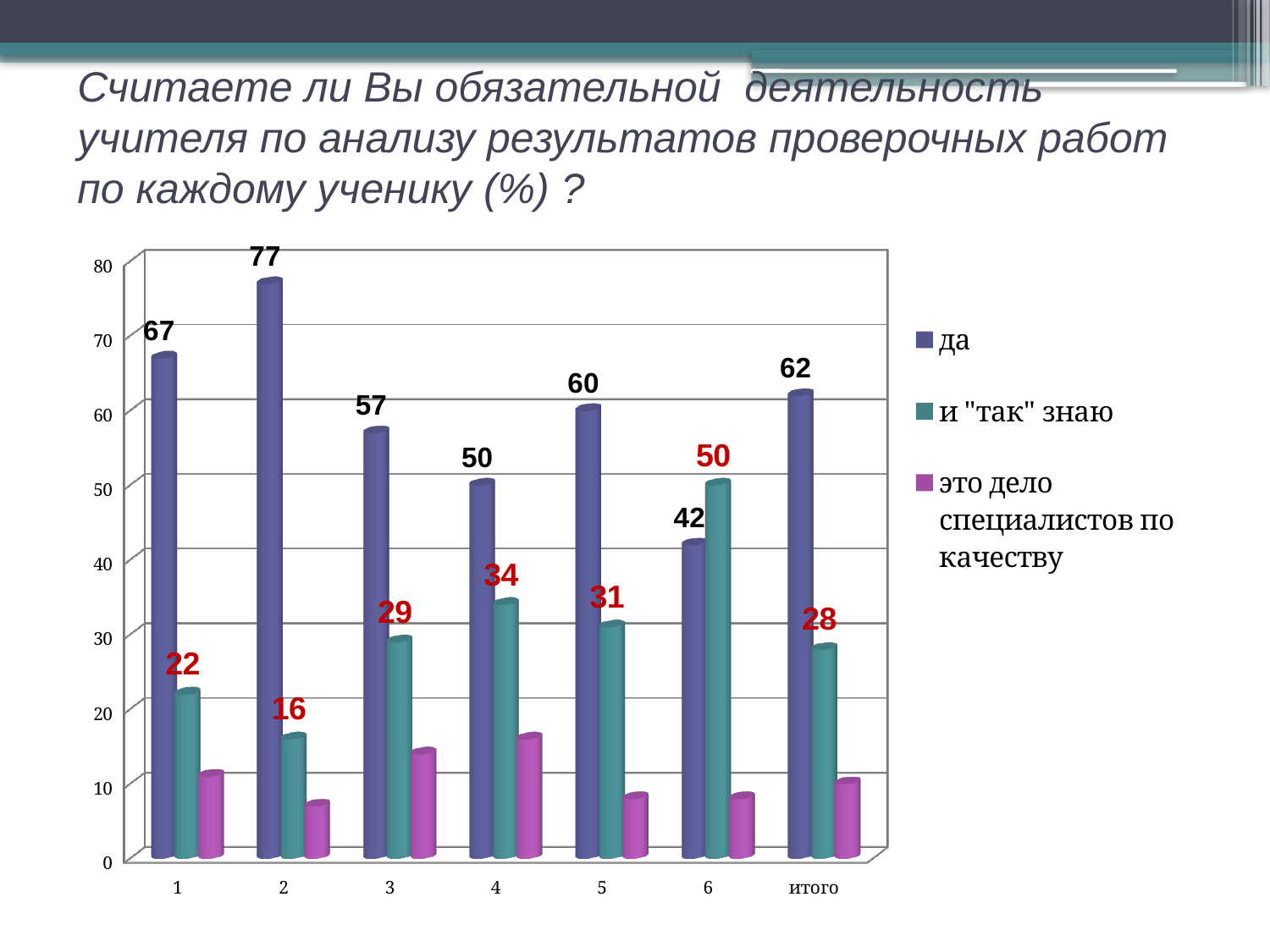
Which category has the lowest value for "да"? 6 What is the difference between the "да" value in category 1 and the "да" value in category 6? 25 What is the value for "и "так" знаю" in category 4? 34 How many series does the legend list? 3 Which category has the highest value for "да"? 2 How many categories are shown on the x axis? 7 What kind of chart is shown on the slide? bar chart Is the value for "это дело специалистов по качеству" in category 4 greater or less than 20? less Which category has the lowest value for "и "так" знаю"? 2 What is the value for "да" in the "итого" category? 62 In category 6, which is larger: "да" or "и "так" знаю"? и "так" знаю What is the value for "да" in category 2? 77